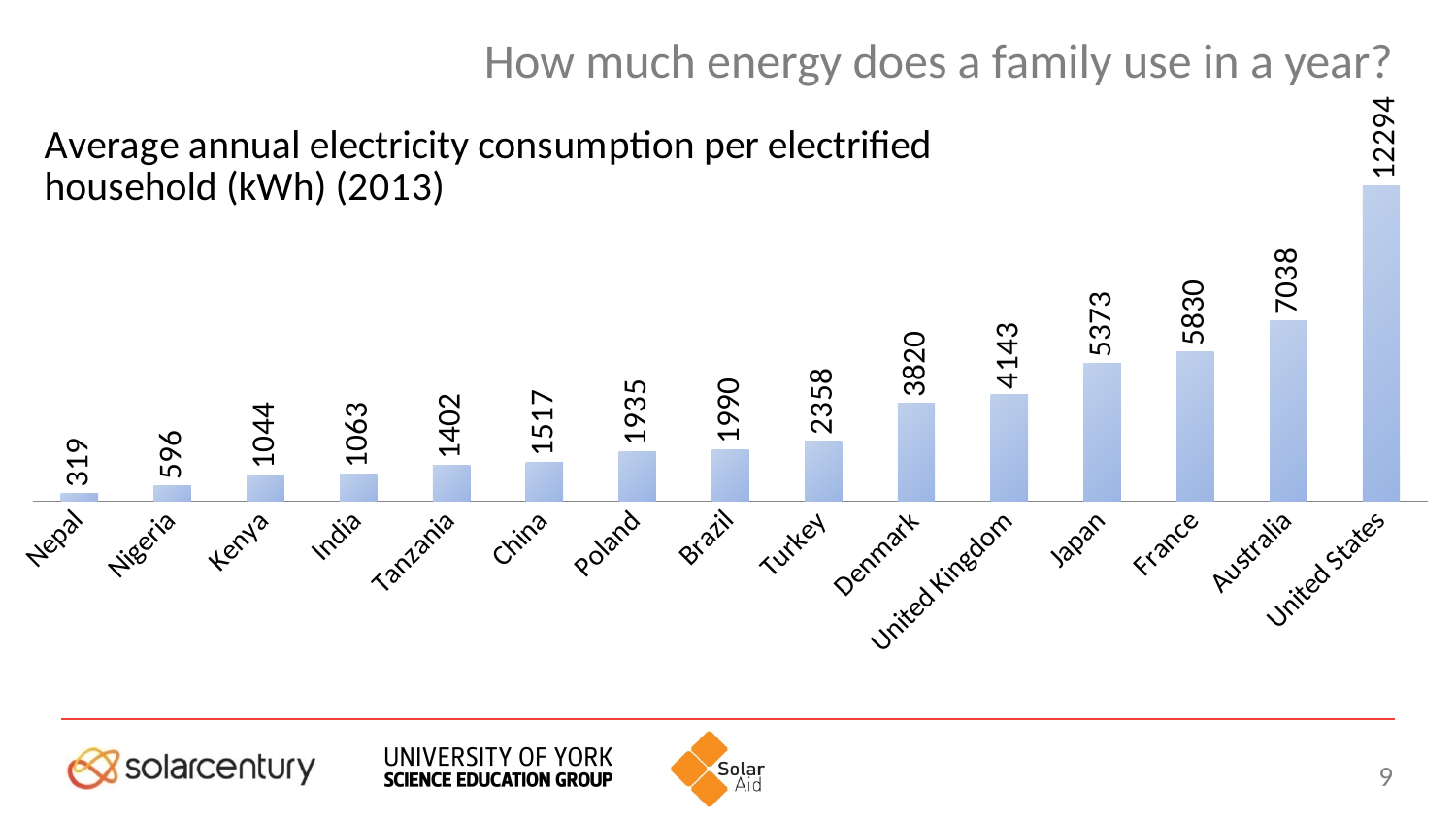
Do the values rise or fall moving from left to right along the x axis? Rise Which country has the highest average annual electricity consumption per electrified household? United States What is the average annual electricity consumption per electrified household for Kenya? 1044 Which has a higher value, Denmark or Brazil? Denmark How many countries are shown in the chart? 15 What value is shown for Turkey? 2358 What is the difference between the values for the United States and the United Kingdom? 8151 What is the title of the chart? Average annual electricity consumption per electrified household (kWh) (2013) Which country has the lowest average annual electricity consumption per electrified household? Nepal What is the difference between the values for Australia and France? 1208 What value is shown for Japan? 5373 What kind of chart is shown on the slide? Bar chart